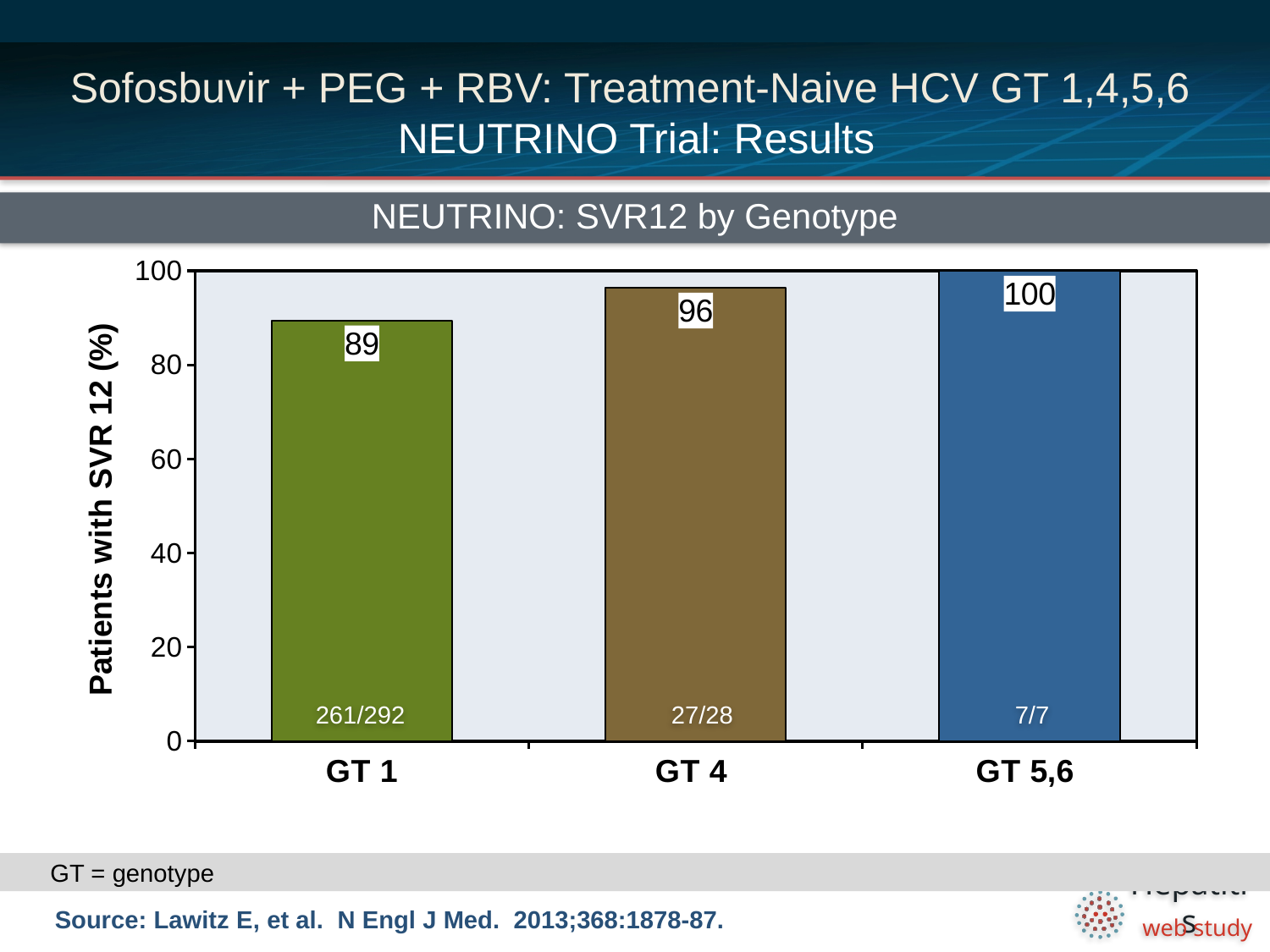
What is the SVR12 value for GT 4? 96 Which genotype group has the lowest SVR12 rate? GT 1 Which has a higher SVR12 rate, GT 1 or GT 4? GT 4 What is the title of the chart? NEUTRINO: SVR12 by Genotype Which genotype group has the highest SVR12 rate? GT 5,6 What is the patient fraction shown inside the GT 1 bar? 261/292 What is the SVR12 value for GT 1? 89 What kind of chart is shown on the slide? Bar chart How many genotype categories are shown on the chart? 3 What is the difference in SVR12 between GT 4 and GT 1? 7 Is the value for GT 1 greater or less than 80? greater What is the SVR12 value for GT 5,6? 100